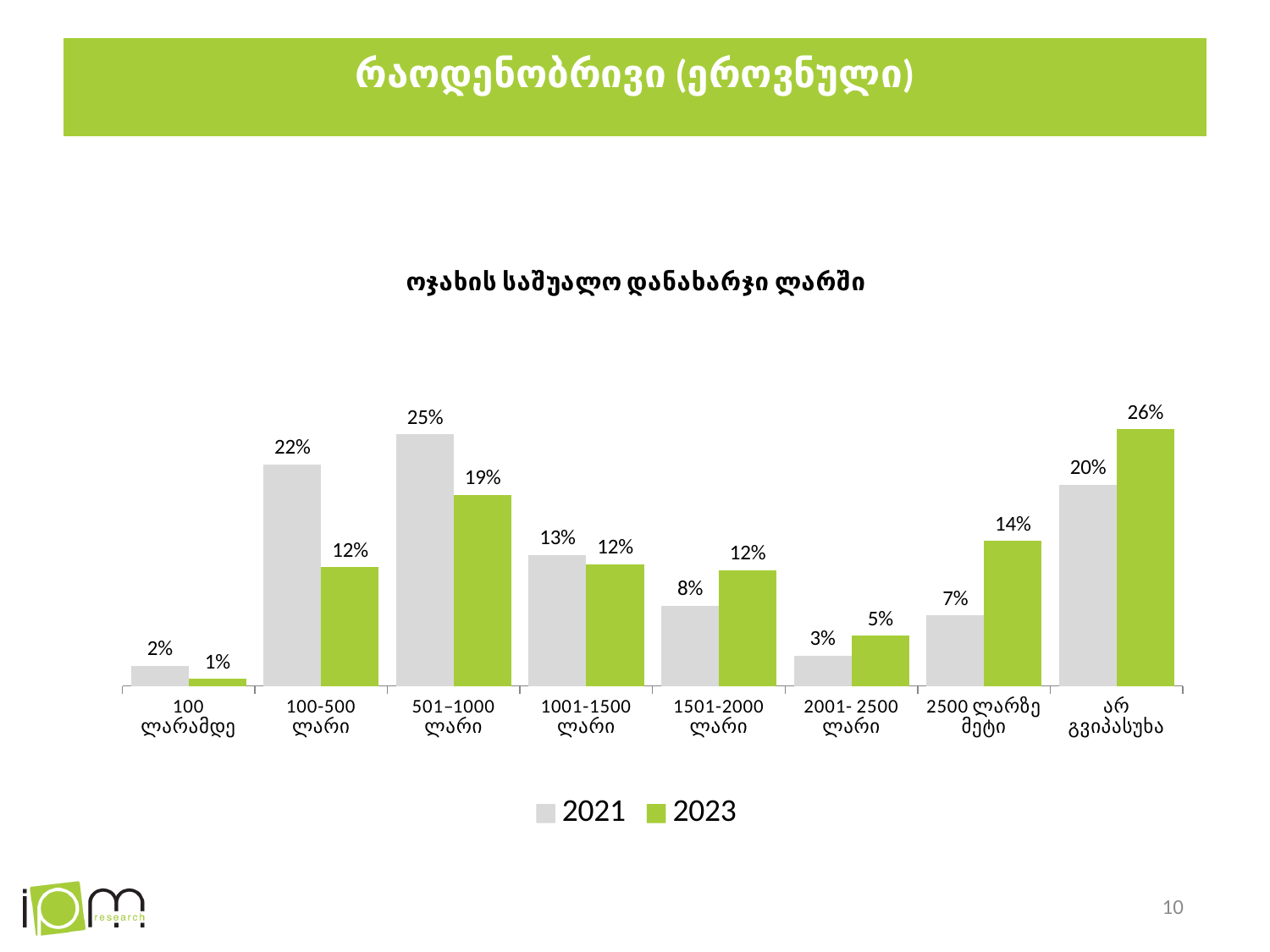
What is the title of the chart? ოჯახის საშუალო დანახარჯი ლარში Which category has the lowest 2021 value? 100 ლარამდე Which is larger for the "1501-2000 ლარი" category, the 2021 value or the 2023 value? 2023 What is the difference between the 2021 and 2023 values for the "100-500 ლარი" category? 10% Which colour represents the 2023 series in the legend? green What is the 2021 value for the "501–1000 ლარი" category? 25% How many categories are shown on the x axis? 8 What is the 2023 value for the "2500 ლარზე მეტი" category? 14% How many series does the legend list? 2 What kind of chart is shown on the slide? bar chart What is the 2023 value for the "100-500 ლარი" category? 12% Which category has the highest 2023 value? არ გვიპასუხა